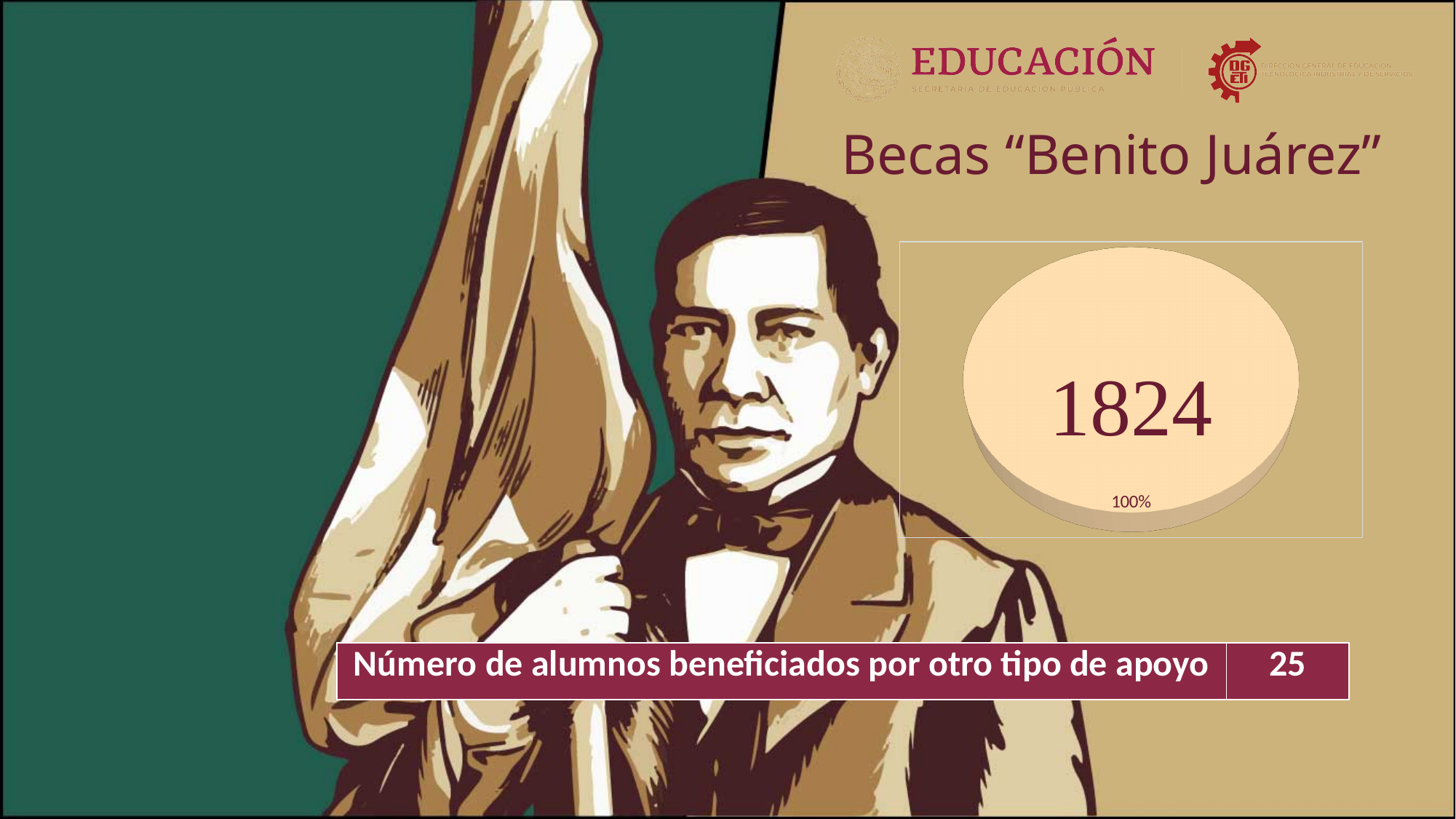
What share of the pie does the single slice represent? 100% Is the value shown on the pie chart greater or less than 1000? greater How many slices does the pie chart have? 1 What is the title shown above the pie chart? Becas "Benito Juárez" What value is printed on the pie chart? 1824 What kind of chart is shown on the slide? pie chart